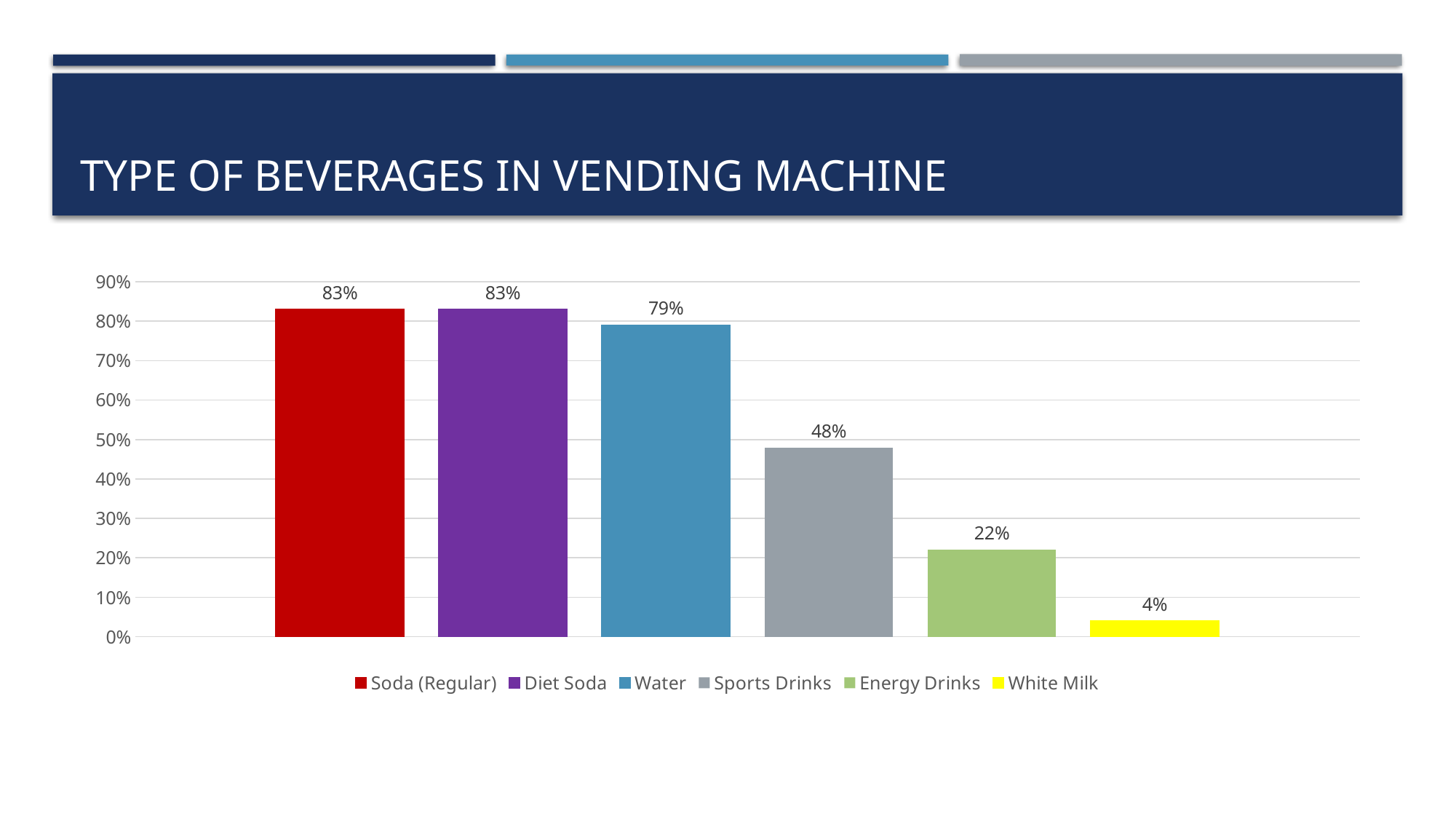
What is the value for Energy Drinks? 22% What is the value for Sports Drinks? 48% What is the value for Water? 79% How many beverage types are shown in the chart? 6 What is the difference between the values for Water and Sports Drinks? 31% What kind of chart is shown on the slide? bar chart What is the value for White Milk? 4% What is the difference between the values for Energy Drinks and White Milk? 18% Which beverage has the lowest value? White Milk Which is larger, the value for Sports Drinks or the value for Energy Drinks? Sports Drinks What is the title of the slide? TYPE OF BEVERAGES IN VENDING MACHINE Is the value for Sports Drinks greater or less than 50%? less